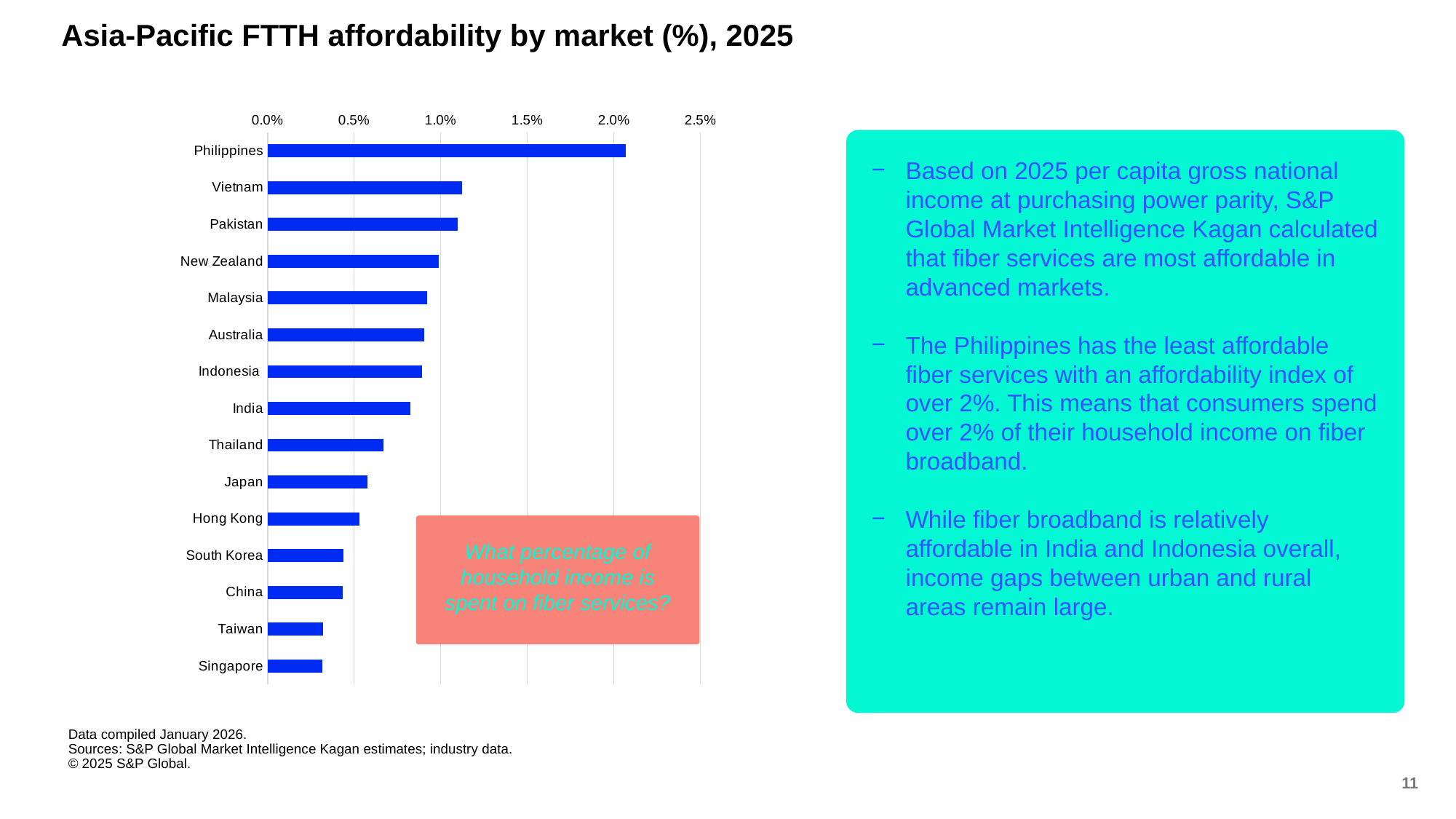
What kind of chart is shown on the slide? bar chart Is the value for South Korea greater or less than 0.5%? less Which market has the highest FTTH affordability value in the chart? Philippines Which has the larger value, India or Thailand? India Is the value for Malaysia greater or less than 1.0%? less Which has the larger value, Japan or Singapore? Japan Is the value for Thailand greater or less than 0.5%? greater How many markets are plotted in the chart? 15 What is the title of the chart? Asia-Pacific FTTH affordability by market (%), 2025